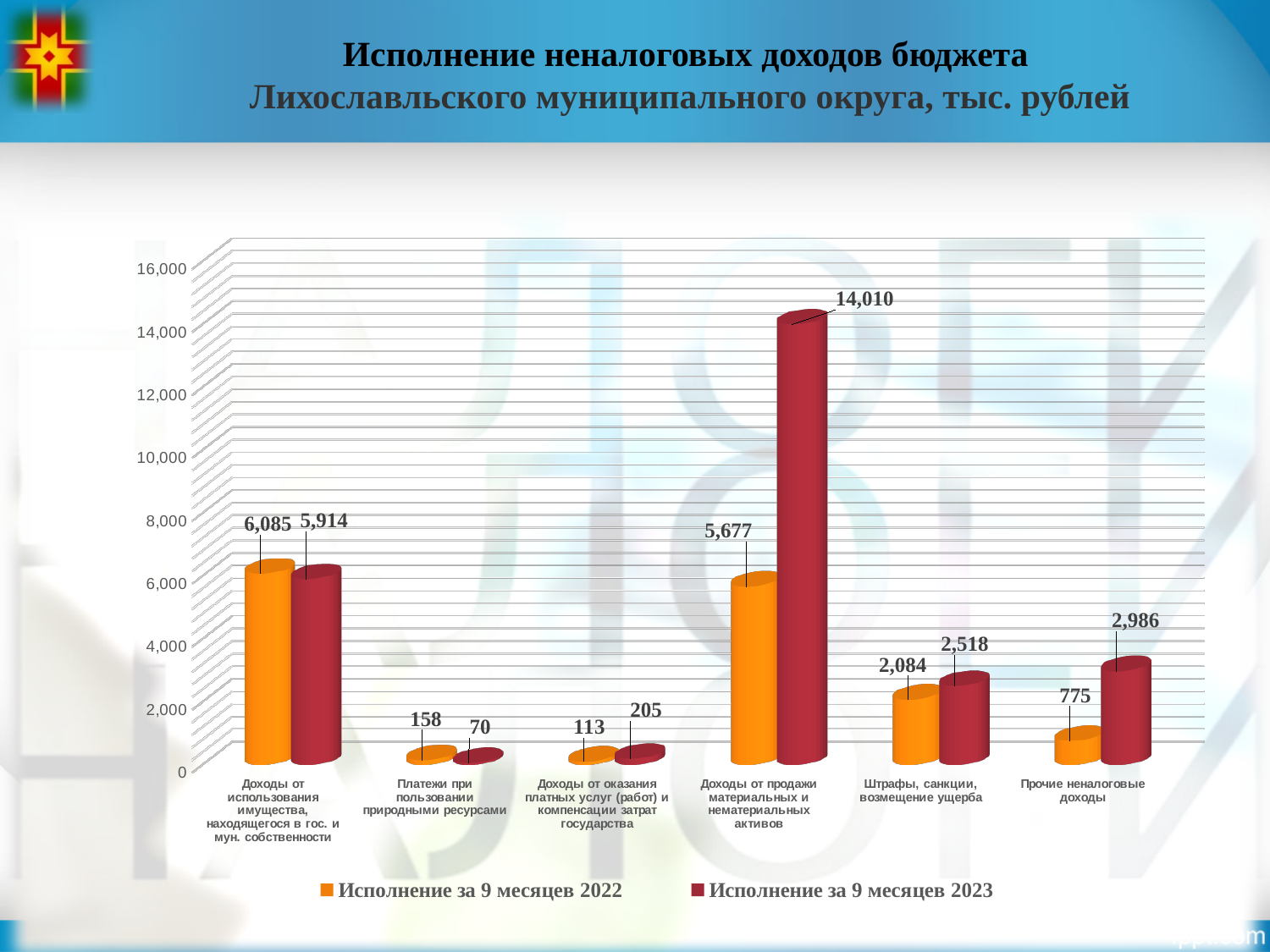
What is the difference between the 2023 and 2022 values for «Доходы от продажи материальных и нематериальных активов»? 8,333 How many categories are shown on the x axis of the chart? 6 Which category has the lowest value in the series «Исполнение за 9 месяцев 2022»? Доходы от оказания платных услуг (работ) и компенсации затрат государства What is the difference between the 2022 and 2023 values for «Платежи при пользовании природными ресурсами»? 88 Is the 2023 value for «Штрафы, санкции, возмещение ущерба» greater or less than 2,000? greater Which category has the highest value in the series «Исполнение за 9 месяцев 2023»? Доходы от продажи материальных и нематериальных активов What is the value for «Доходы от продажи материальных и нематериальных активов» in the series «Исполнение за 9 месяцев 2023»? 14,010 What kind of chart is shown on the slide? Bar chart What is the value for «Штрафы, санкции, возмещение ущерба» in the series «Исполнение за 9 месяцев 2022»? 2,084 What is the value for «Прочие неналоговые доходы» in the series «Исполнение за 9 месяцев 2023»? 2,986 How many series does the legend list? 2 For «Доходы от использования имущества, находящегося в гос. и мун. собственности», which series has the larger value: «Исполнение за 9 месяцев 2022» or «Исполнение за 9 месяцев 2023»? Исполнение за 9 месяцев 2022